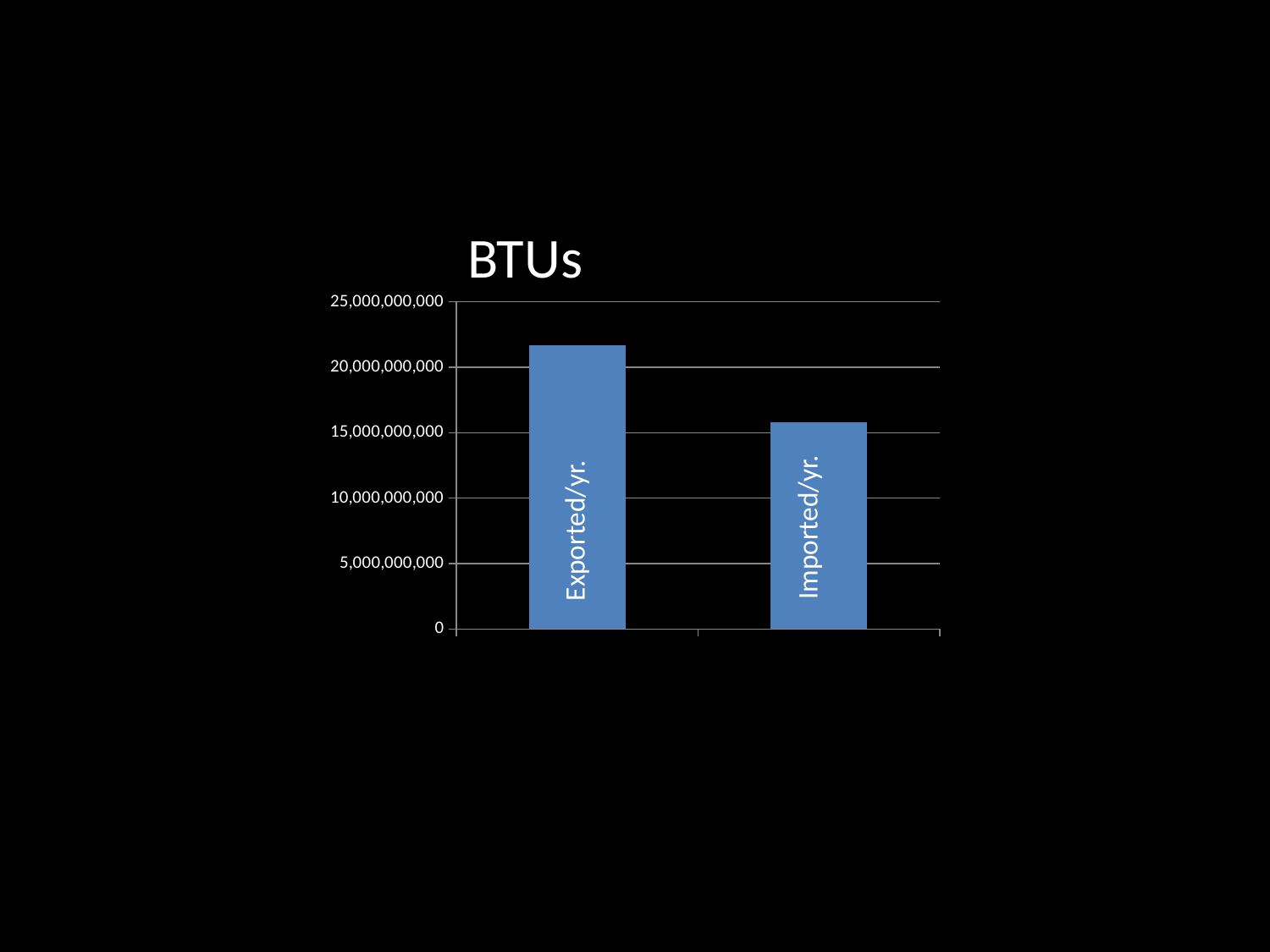
Which category has the lowest value? Imported/yr. Which is larger, the value for Exported/yr. or Imported/yr.? Exported/yr. Which category has the highest value? Exported/yr. Is the value for Exported/yr. greater or less than 20,000,000,000? greater What kind of chart is shown on the slide? bar chart What is the title of the chart? BTUs What is the highest value shown on the vertical axis? 25,000,000,000 Is the value for Imported/yr. greater or less than 15,000,000,000? greater How many bars are plotted in the chart? 2 Is the value for Exported/yr. greater or less than 25,000,000,000? less Do the values rise or fall from Exported/yr. to Imported/yr.? fall